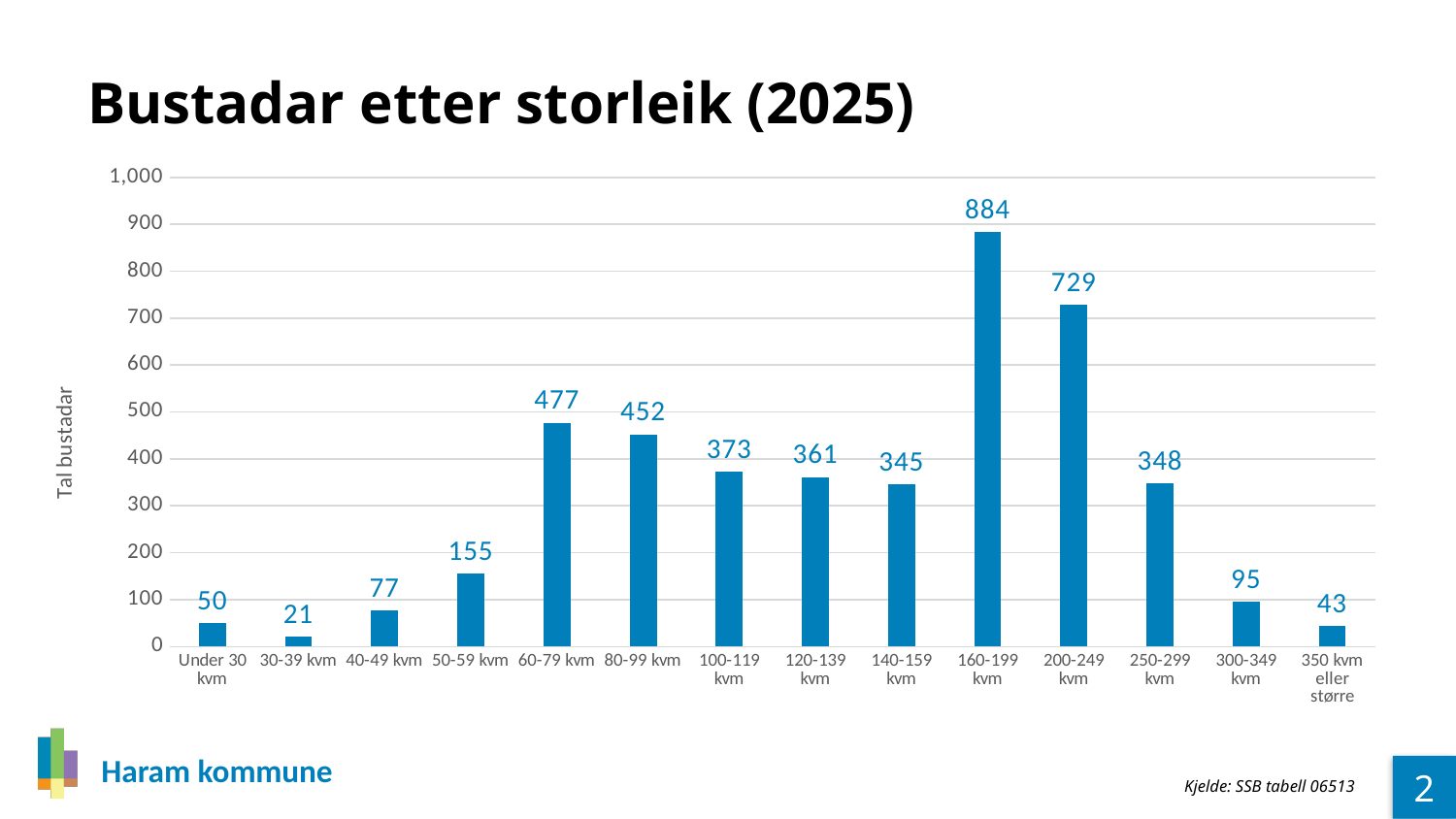
What is the difference between the values for 160-199 kvm and 200-249 kvm? 155 What is the value for 160-199 kvm? 884 What is the value for 50-59 kvm? 155 Is the value for 200-249 kvm greater or less than 700? greater What is the title of the chart? Bustadar etter storleik (2025) What kind of chart is shown on the slide? bar chart What is the difference between the values for 60-79 kvm and 80-99 kvm? 25 How many categories are shown on the x axis? 14 Which category has the lowest value? 30-39 kvm Which is larger, the value for 100-119 kvm or the value for 250-299 kvm? 100-119 kvm Which category has the highest value? 160-199 kvm What is the value for 350 kvm eller større? 43